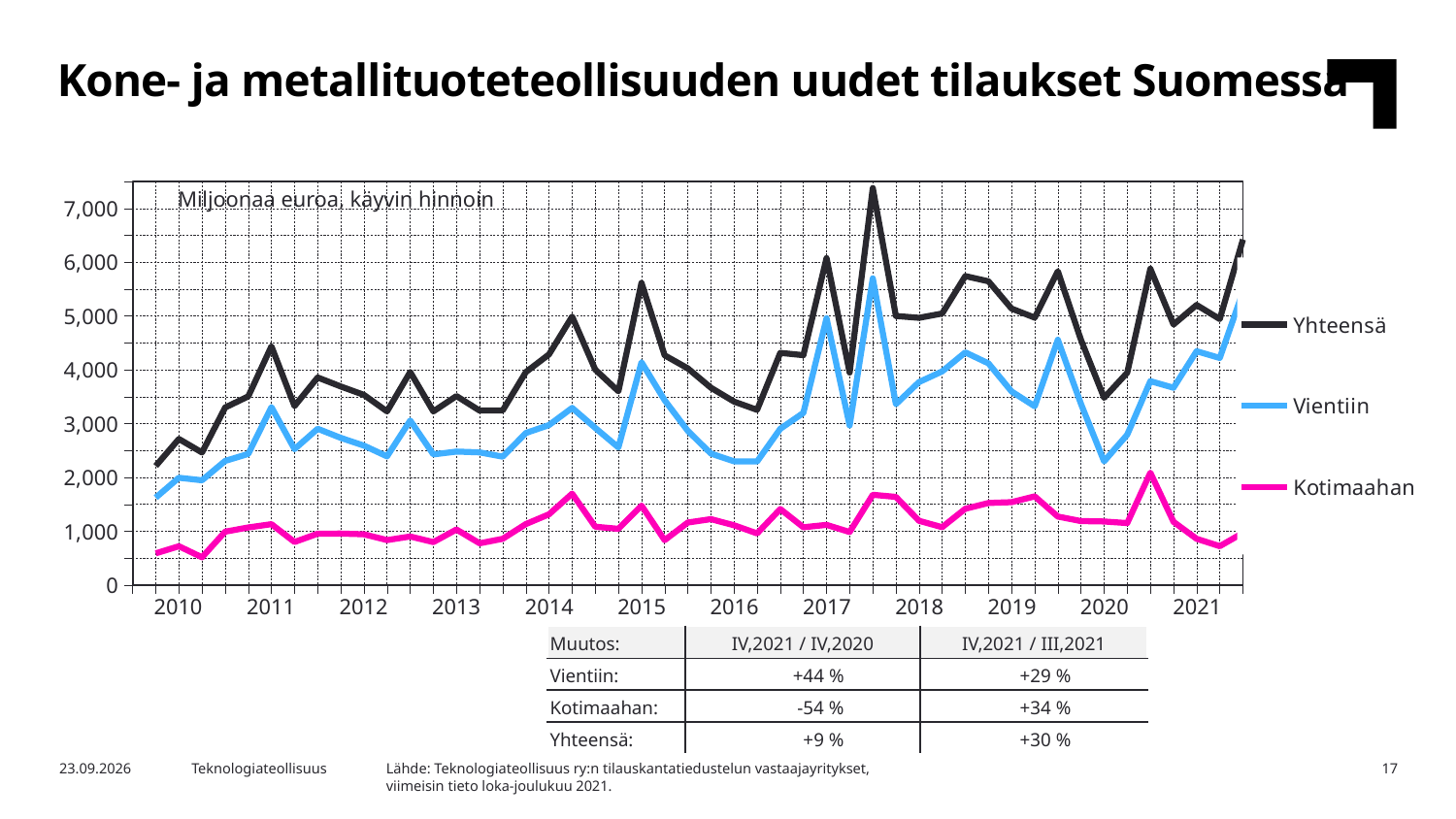
How many years are labelled on the x axis? 12 Is the final value for Yhteensä at the end of 2021 greater or less than 6,000? greater What type of chart is shown on the slide? line chart Is the peak value of Yhteensä in 2017 greater or less than 7,000? greater Which series is larger in 2019, Vientiin or Kotimaahan? Vientiin How many series does the legend list? 3 Is the value for Kotimaahan ever greater or less than 3,000 across the whole chart? less Which series is plotted with the black line? Yhteensä What unit is stated in the label inside the chart area? Miljoonaa euroa, käyvin hinnoin Which series has the lowest values throughout the chart? Kotimaahan Which series has the highest values throughout the chart? Yhteensä